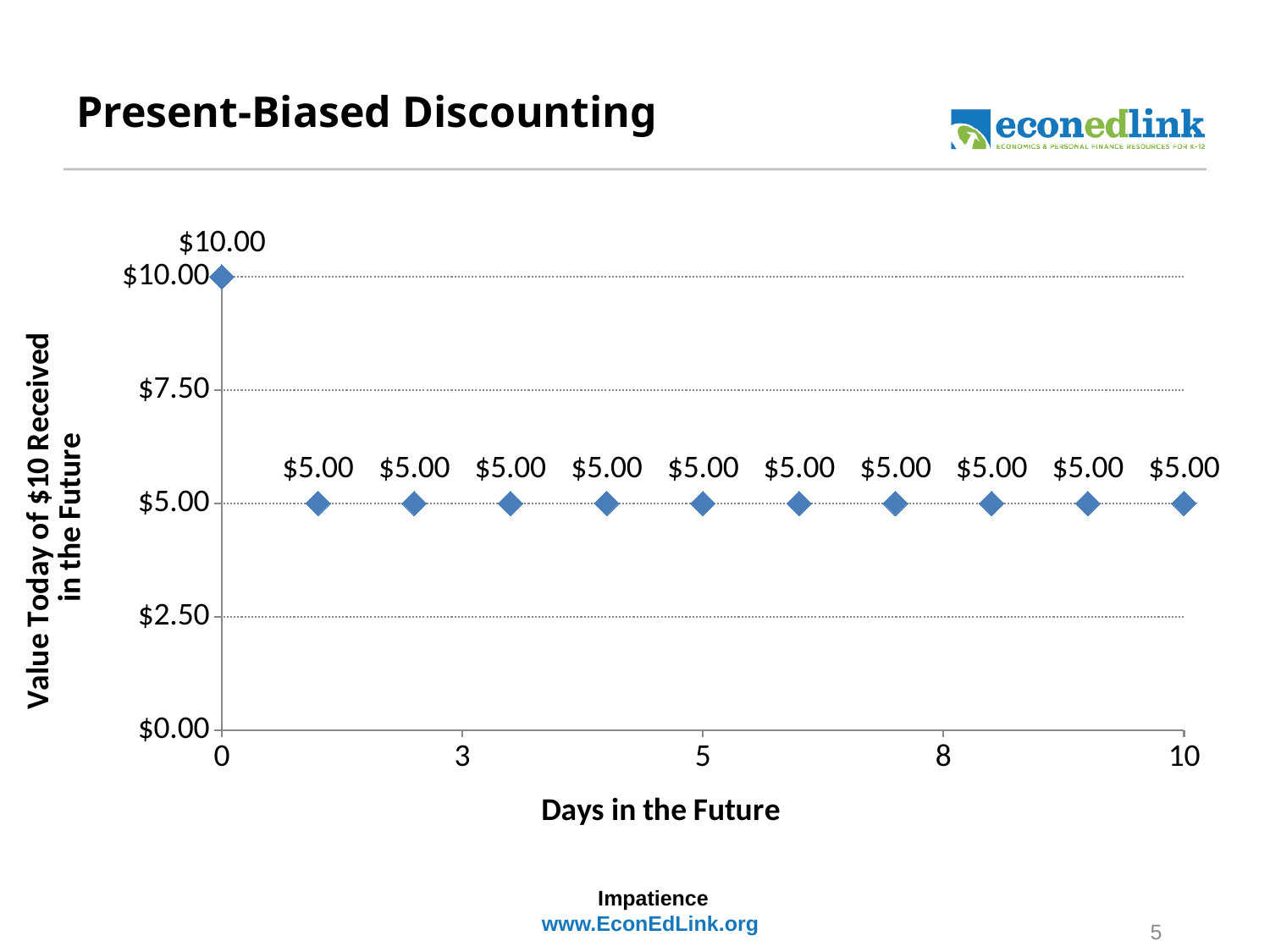
At how many days in the future is the value today highest? 0 What is the value today of $10 received 0 days in the future? $10.00 What is the highest value plotted on the chart? $10.00 What is the label of the x axis? Days in the Future How many data points are plotted on the chart? 11 What is the value today of $10 received 5 days in the future? $5.00 What kind of chart is shown on the slide? scatter chart What is the difference between the value at 0 days and the value at 10 days in the future? $5.00 Which is larger: the value at 0 days or the value at 3 days in the future? 0 days What is the lowest value plotted on the chart? $5.00 What is the value today of $10 received 10 days in the future? $5.00 Is the value at 8 days in the future greater or less than $7.50? less